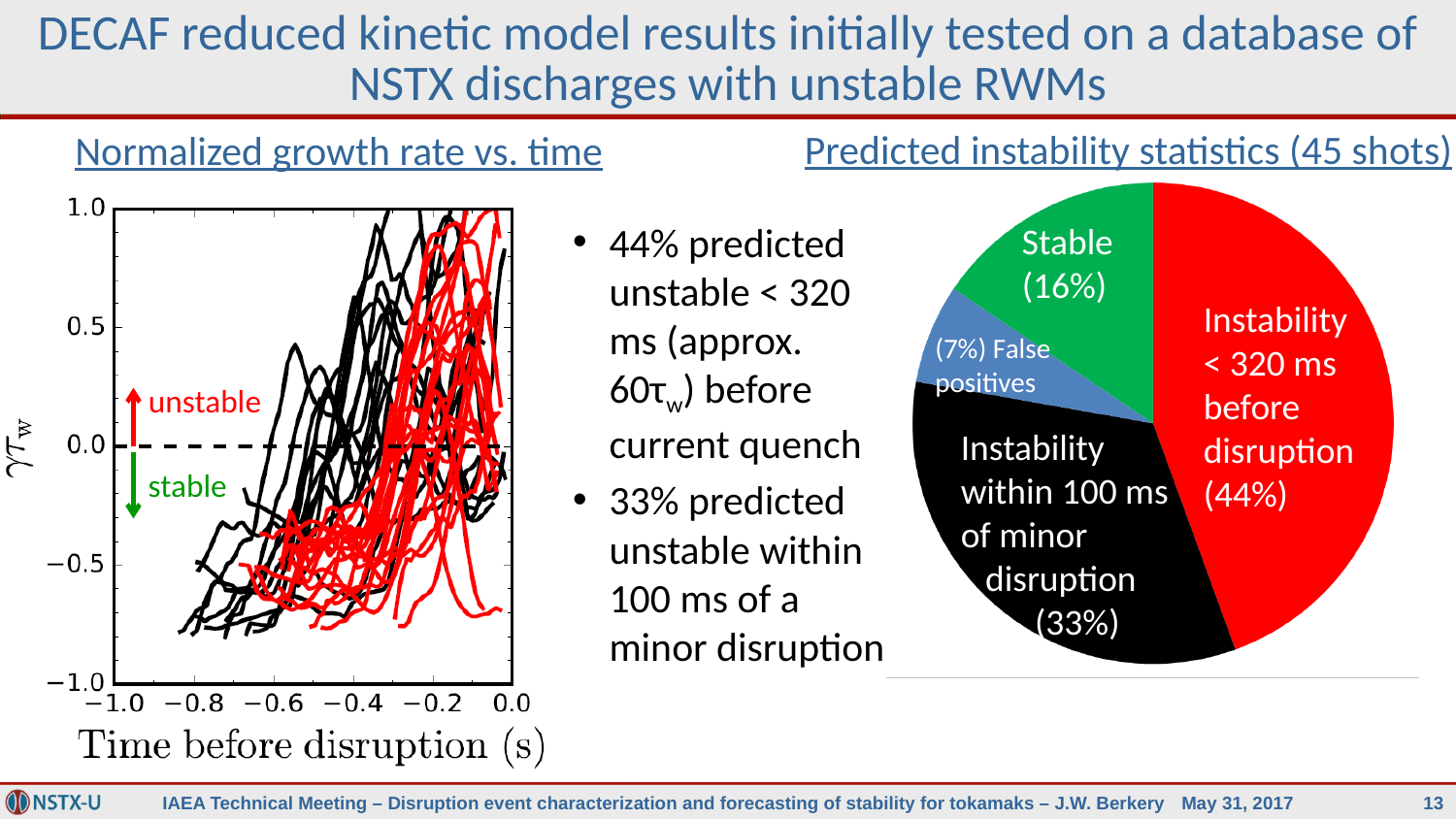
In the 'Predicted instability statistics (45 shots)' chart, what share of shots is labelled 'Stable'? 16% In the 'Predicted instability statistics (45 shots)' chart, what share of shots is labelled 'Instability < 320 ms before disruption'? 44% In the 'Predicted instability statistics (45 shots)' chart, which is larger: the 'Stable' slice or the 'False positives' slice? Stable How many slices does the 'Predicted instability statistics (45 shots)' pie chart have? 4 In the 'Predicted instability statistics (45 shots)' chart, what share of shots is labelled 'Instability within 100 ms of minor disruption'? 33% What kind of chart is the 'Predicted instability statistics (45 shots)' chart? Pie chart In the 'Predicted instability statistics (45 shots)' chart, what is the difference in percentage points between the 'Instability < 320 ms before disruption' slice and the 'Instability within 100 ms of minor disruption' slice? 11 percentage points In the 'Predicted instability statistics (45 shots)' chart, what share of shots is labelled 'False positives'? 7% In the 'Predicted instability statistics (45 shots)' chart, which slice is the largest? Instability < 320 ms before disruption In the 'Normalized growth rate vs. time' chart, what is the label of the x axis? Time before disruption (s) In the 'Predicted instability statistics (45 shots)' chart, which slice is the smallest? False positives What kind of chart is the 'Normalized growth rate vs. time' chart on the left? Line chart